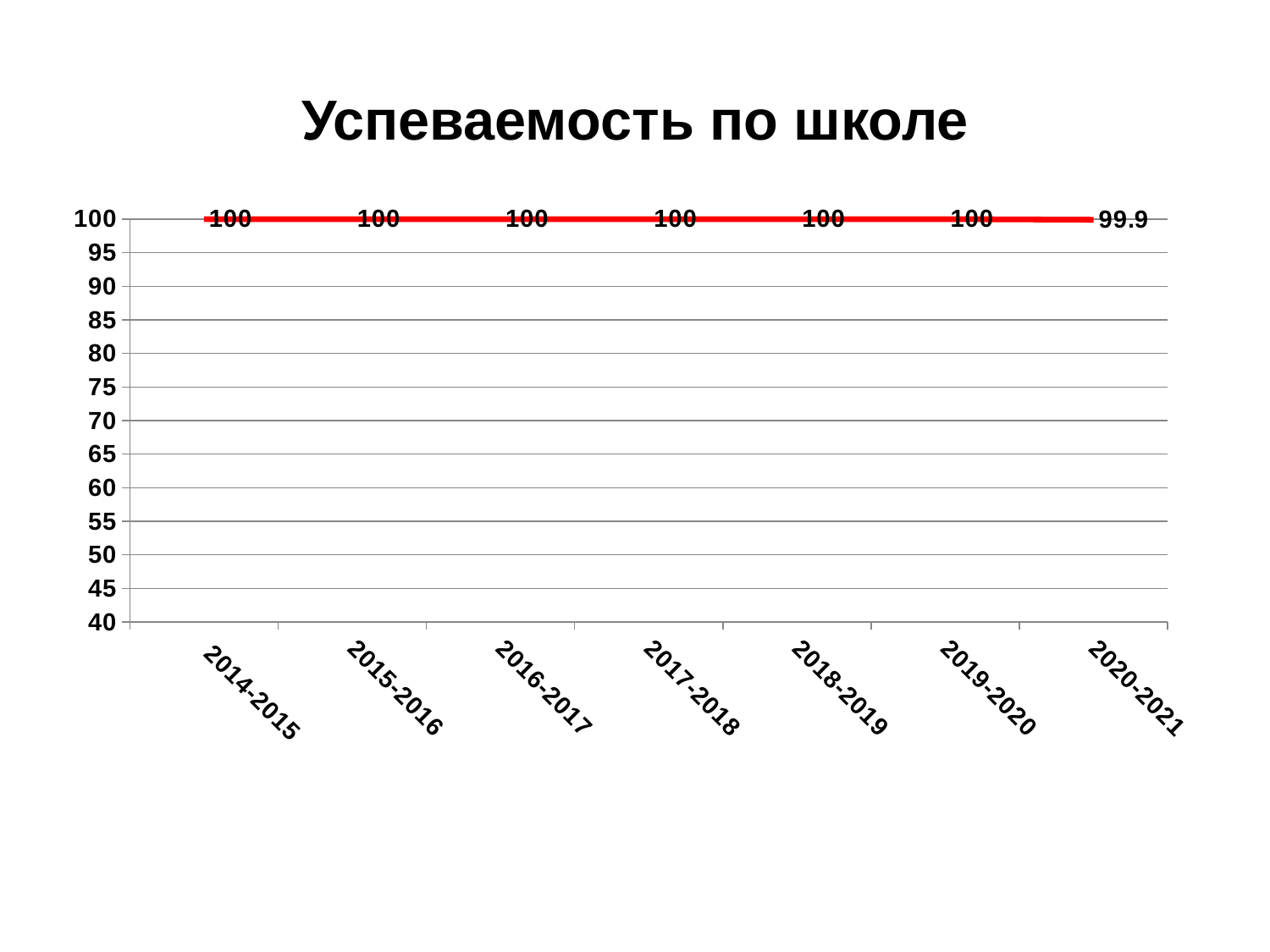
Do the values rise, fall or stay flat from 2014-2015 to 2019-2020? stay flat Is the value for 2016-2017 greater or less than 95? greater What is the title of the chart? Успеваемость по школе What is the value for 2018-2019? 100 How many school years are plotted on the x axis? 7 Which school year has the lowest value? 2020-2021 What kind of chart is shown on the slide? line chart What is the difference between the values for 2019-2020 and 2020-2021? 0.1 Which is larger, the value for 2017-2018 or the value for 2020-2021? 2017-2018 What is the value for 2014-2015? 100 What colour is the plotted line? red What is the value for 2020-2021? 99.9